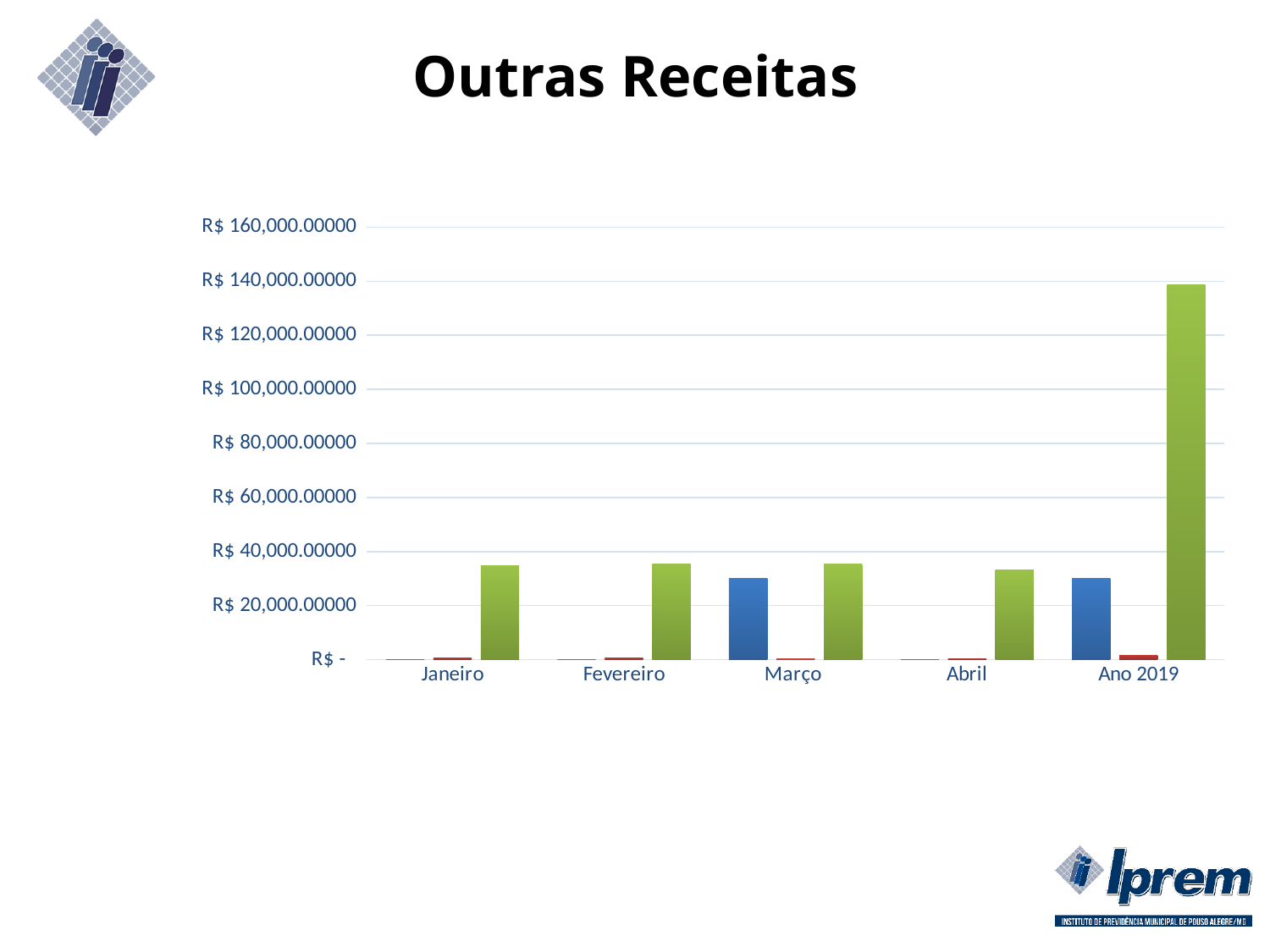
Which is larger: the green bar for Ano 2019 or the green bar for Abril? the green bar for Ano 2019 Is the value of the green bar for Fevereiro greater or less than R$ 20,000.00000? greater Which is larger for Março: the blue bar or the green bar? the green bar What kind of chart is shown on the slide? bar chart Is the value of the green bar for Janeiro greater or less than R$ 40,000.00000? less How many categories are shown on the x axis of the chart? 5 Is the value of the blue bar for Março greater or less than R$ 20,000.00000? greater What is the label of the last category on the x axis? Ano 2019 Which category has the tallest bar in the chart? Ano 2019 What is the title of the chart? Outras Receitas